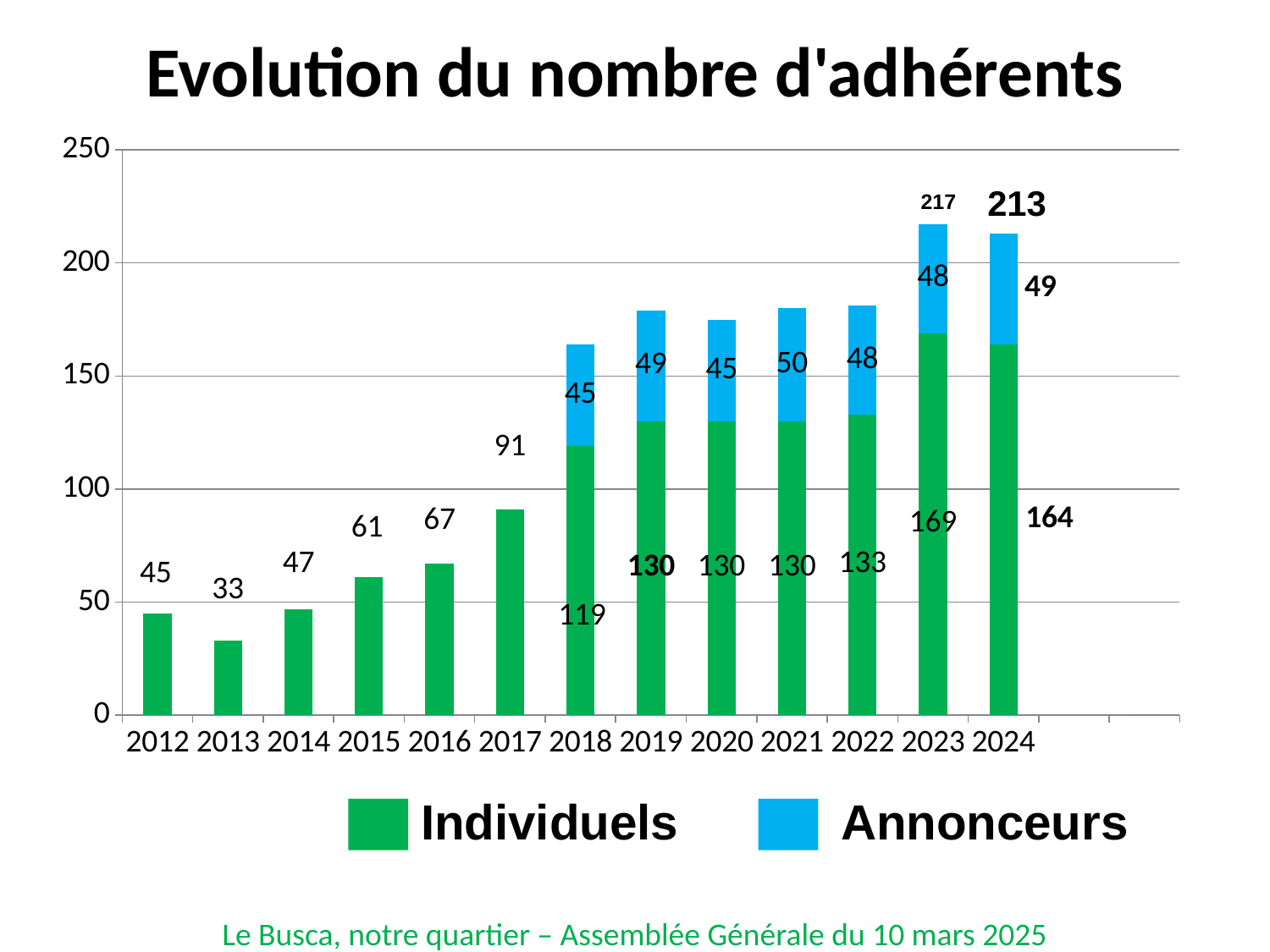
What is the value for Annonceurs in 2021? 50 What is the value for Individuels in 2017? 91 How many series does the legend list? 2 What kind of chart is shown on the slide? Stacked bar chart Is the total height of the 2018 bar greater or less than 150? greater How many years are shown on the x axis? 13 Which year has the lowest value for Individuels? 2013 What is the title of the chart? Evolution du nombre d'adhérents Which is larger, the Individuels value for 2015 or for 2016? 2016 Which year has the highest value for Individuels? 2023 What is the difference between the Individuels values for 2023 and 2024? 5 What is the total of the stacked bar for 2023? 217